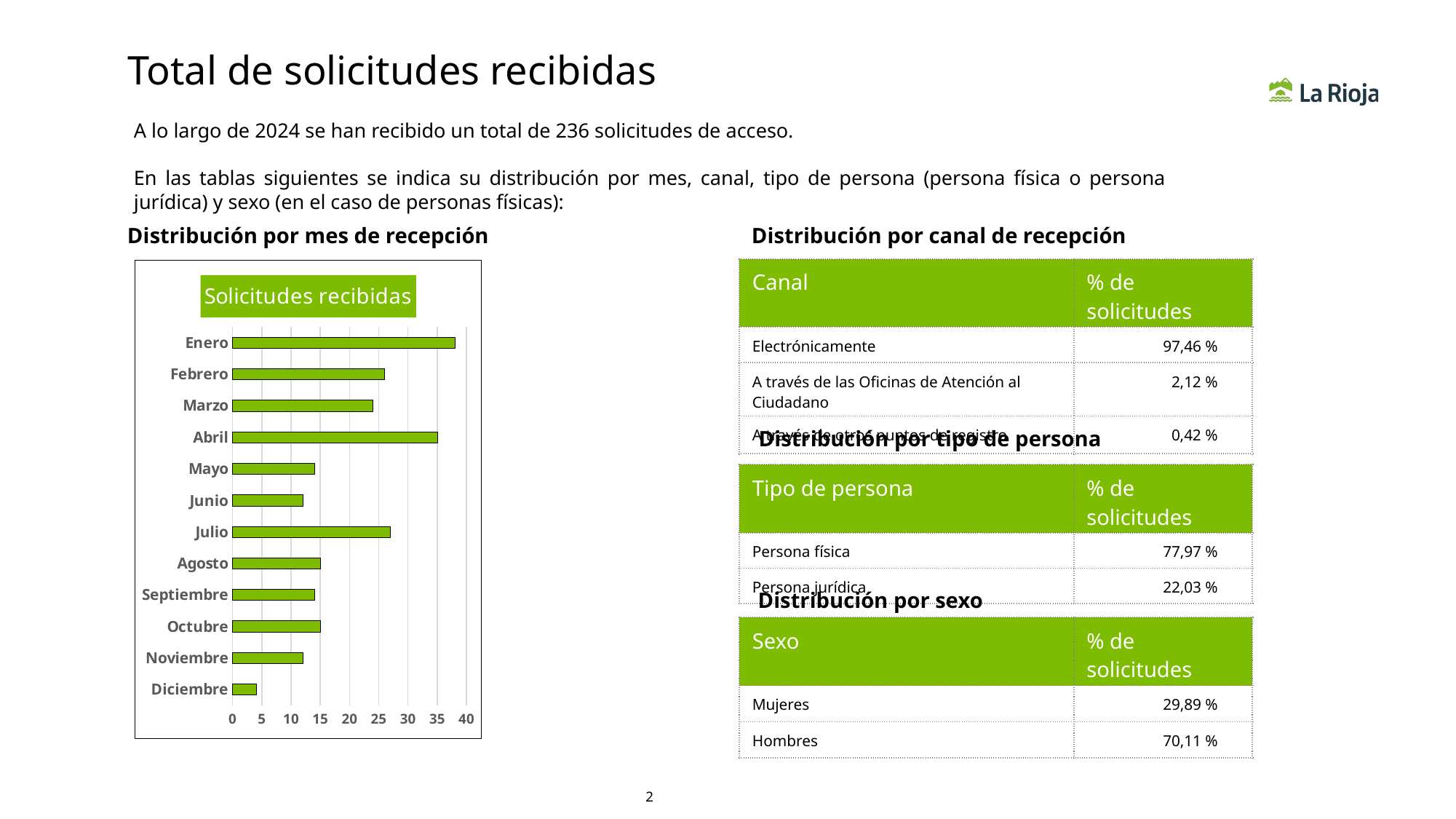
In the bar chart, is the value for Abril greater or less than 30? greater In the bar chart, which month has more solicitudes recibidas, Noviembre or Diciembre? Noviembre Which month has the highest number of solicitudes recibidas in the bar chart? Enero In the bar chart, is the value for Diciembre greater or less than 5? less How many months are plotted in the 'Solicitudes recibidas' chart? 12 In the bar chart, is the value for Enero greater or less than 35? greater Which month has the lowest number of solicitudes recibidas in the bar chart? Diciembre What kind of chart is shown under 'Distribución por mes de recepción'? bar chart In the bar chart, which month has more solicitudes recibidas, Abril or Julio? Abril What is the title shown inside the bar chart? Solicitudes recibidas